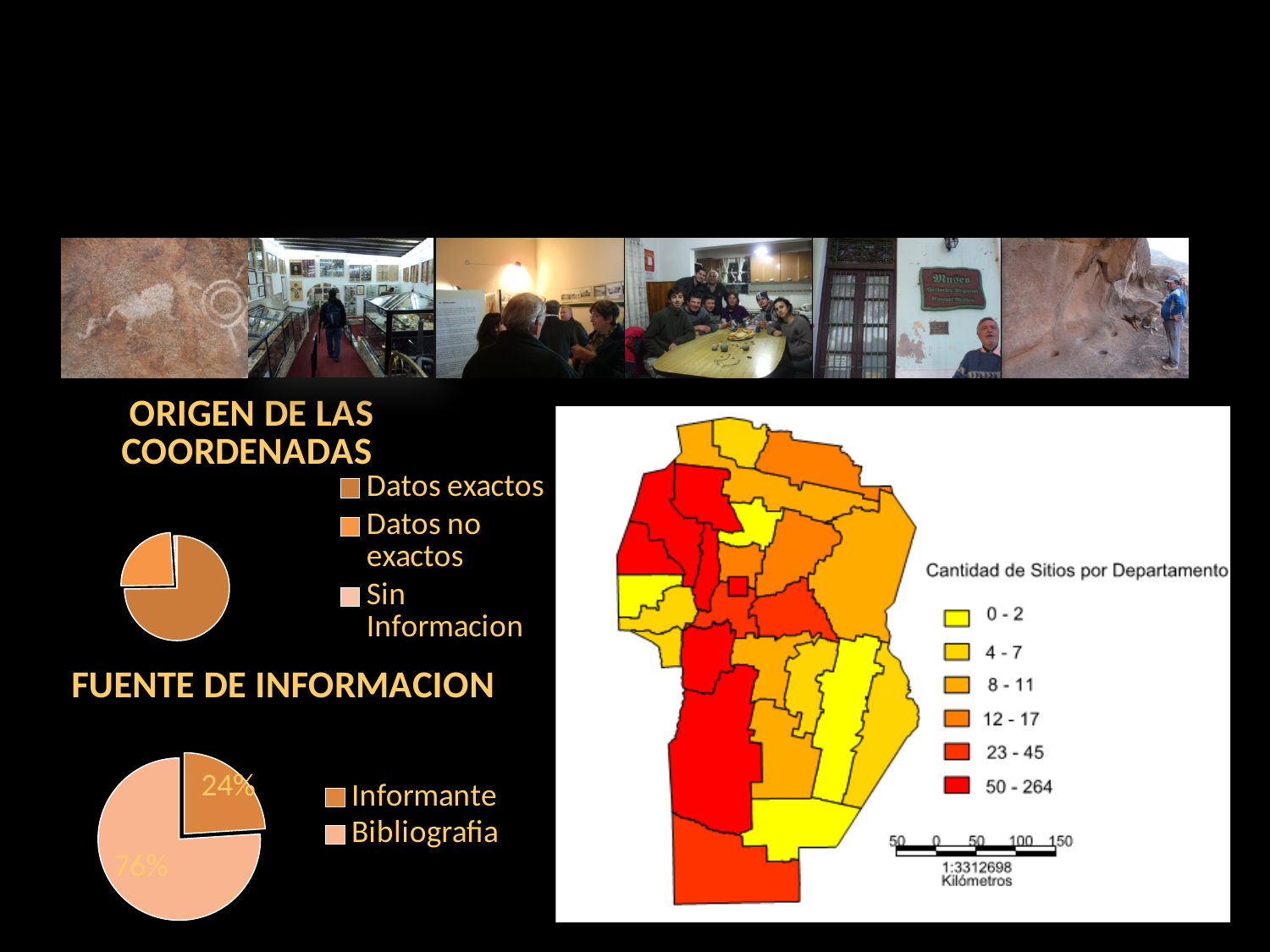
In the FUENTE DE INFORMACION chart, what share does Bibliografia have? 76% In the FUENTE DE INFORMACION chart, which is larger, Informante or Bibliografia? Bibliografia What is the title of the pie chart at the top left of the slide? ORIGEN DE LAS COORDENADAS How many entries does the legend of the ORIGEN DE LAS COORDENADAS chart list? 3 In the ORIGEN DE LAS COORDENADAS chart, which is larger, Datos exactos or Datos no exactos? Datos exactos In the ORIGEN DE LAS COORDENADAS chart, which category has the largest slice? Datos exactos In the FUENTE DE INFORMACION chart, which category has the smallest slice? Informante How many entries does the legend of the FUENTE DE INFORMACION chart list? 2 What kind of chart is the ORIGEN DE LAS COORDENADAS chart? Pie chart What kind of chart is the FUENTE DE INFORMACION chart? Pie chart In the FUENTE DE INFORMACION chart, what share does Informante have? 24% In the FUENTE DE INFORMACION chart, what is the difference in percentage points between Bibliografia and Informante? 52 percentage points